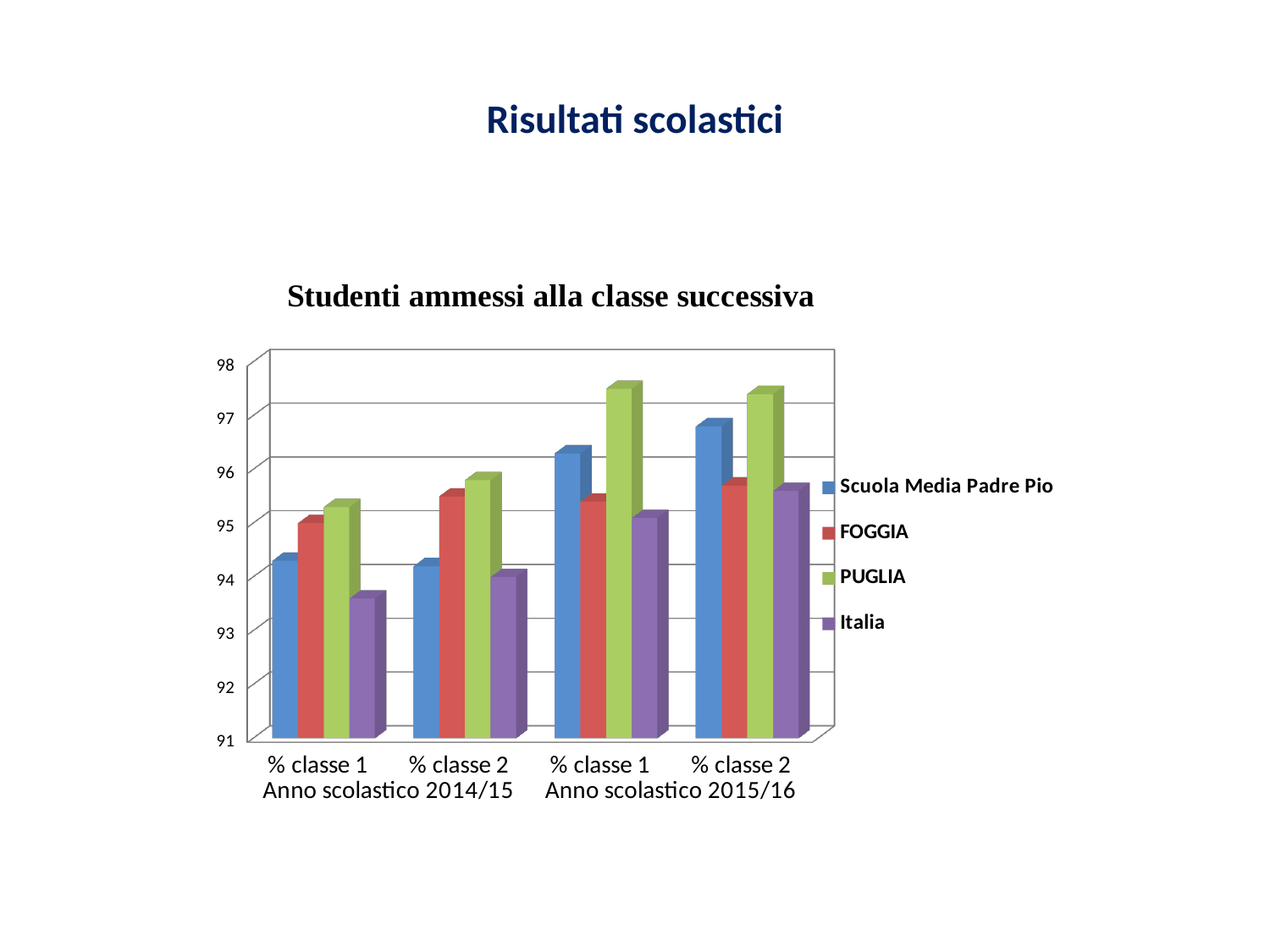
How many categories are shown along the x axis? 4 In % classe 1 Anno scolastico 2015/16, which is larger: Scuola Media Padre Pio or FOGGIA? Scuola Media Padre Pio What is the title of the chart? Studenti ammessi alla classe successiva Which series has the lowest value in % classe 1 Anno scolastico 2014/15? Italia Which series has the highest value in % classe 1 Anno scolastico 2015/16? PUGLIA What kind of chart is shown on the slide? bar chart Is the value for Scuola Media Padre Pio in % classe 2 Anno scolastico 2015/16 greater or less than 96? greater How many series does the legend list? 4 Does the value for Scuola Media Padre Pio rise or fall from % classe 2 Anno scolastico 2014/15 to % classe 1 Anno scolastico 2015/16? rise Is the value for Italia in % classe 1 Anno scolastico 2014/15 greater or less than 94? less Which series is shown in green in the legend? PUGLIA Is the value for PUGLIA in % classe 1 Anno scolastico 2015/16 greater or less than 97? greater